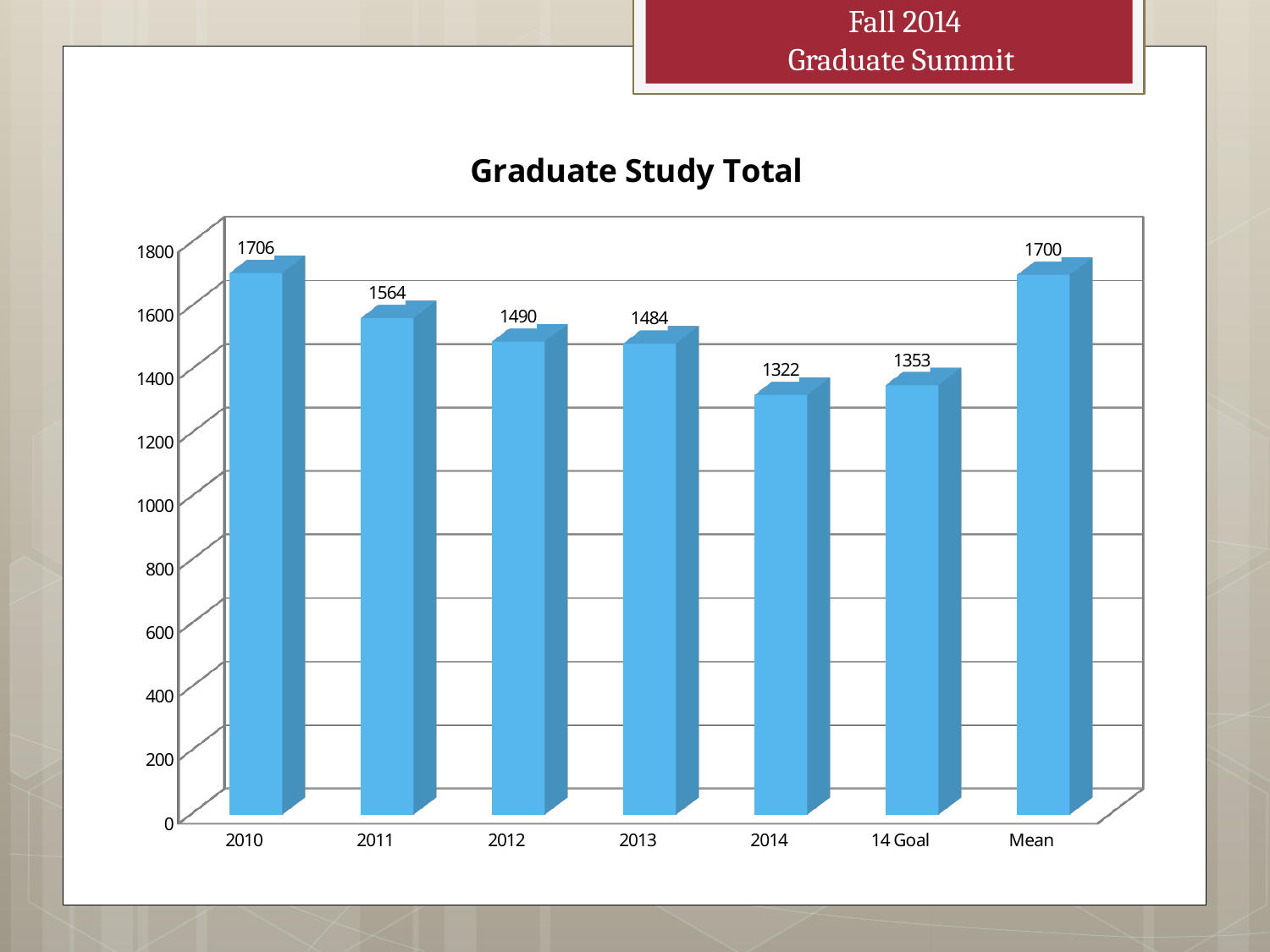
What is the value for 14 Goal in the Graduate Study Total chart? 1353 What is the value for 2010 in the Graduate Study Total chart? 1706 Which category has the highest value in the Graduate Study Total chart? 2010 What is the difference between the values for 2010 and 2014 in the Graduate Study Total chart? 384 Which is larger in the Graduate Study Total chart, the value for 2011 or the value for 2012? 2011 What is the difference between the values for 14 Goal and 2014 in the Graduate Study Total chart? 31 Do the values rise or fall from 2010 to 2014 in the Graduate Study Total chart? Fall What is the value for Mean in the Graduate Study Total chart? 1700 How many bars are shown in the Graduate Study Total chart? 7 What kind of chart is shown on the slide? Bar chart Which category has the lowest value in the Graduate Study Total chart? 2014 What is the value for 2014 in the Graduate Study Total chart? 1322